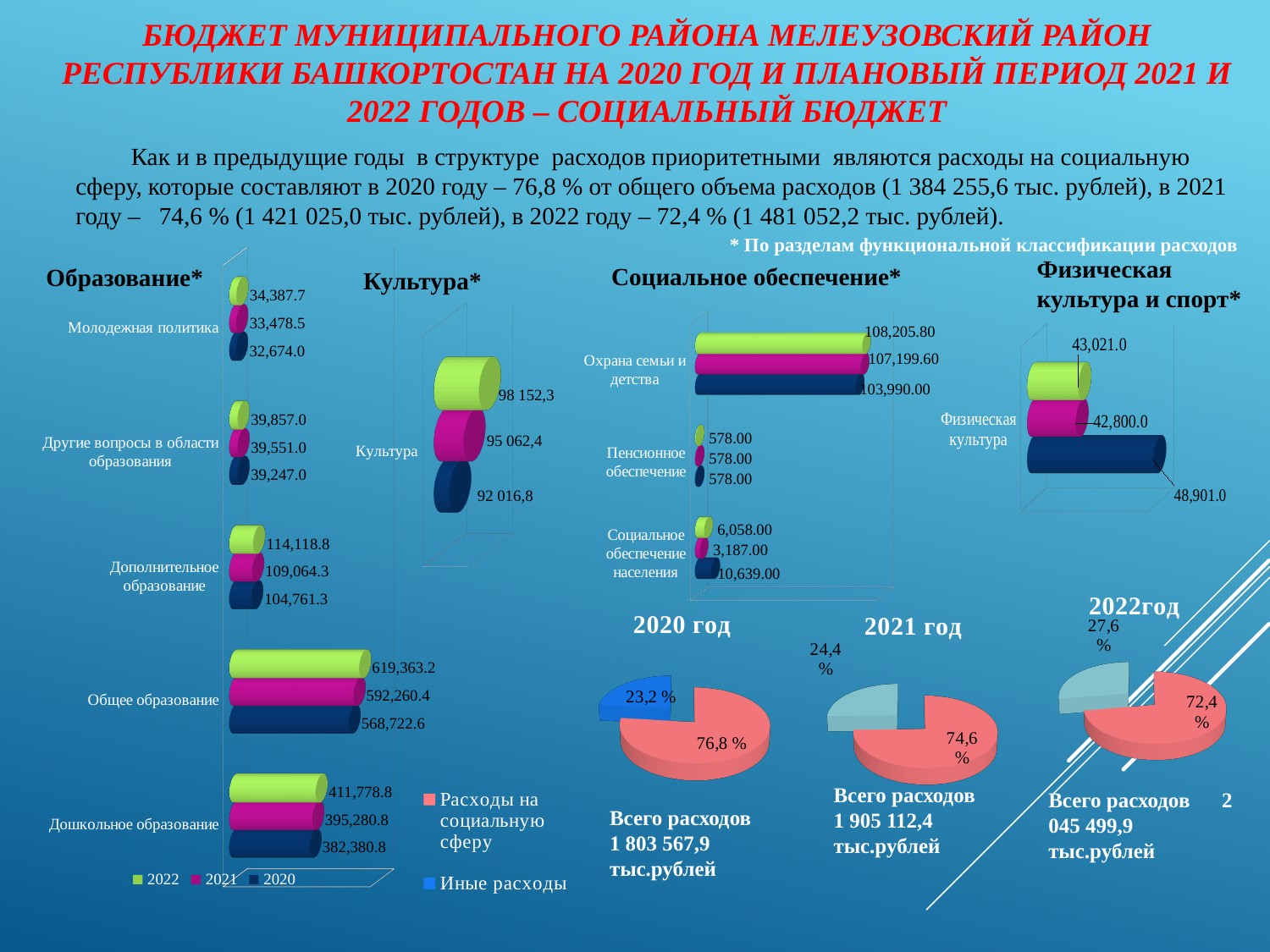
In the 'Образование*' chart, how many categories are shown? 5 In the 'Образование*' chart, what is the value for Дошкольное образование in the 2020 series? 382,380.8 In the 'Образование*' chart, how many series does the legend list? 3 In the 'Социальное обеспечение*' chart, what is the difference between the 2022 and 2020 values for Охрана семьи и детства? 4,215.80 In the 'Физическая культура и спорт*' chart, which series has the larger value: 2020 or 2022? 2020 What type of chart is used for '2020 год', '2021 год' and '2022год'? Pie chart In the 'Социальное обеспечение*' chart, what is the 2020 value for Социальное обеспечение населения? 10,639.00 In the '2021 год' pie chart, what share is shown for Расходы на социальную сферу? 74,6 % In the 'Образование*' chart, what is the value for Общее образование in the 2022 series? 619,363.2 In the 'Образование*' chart, which category has the highest values? Общее образование In the 'Культура*' chart, what is the value for the 2021 series? 95 062,4 In the 'Образование*' chart, which category has the lowest values? Молодежная политика